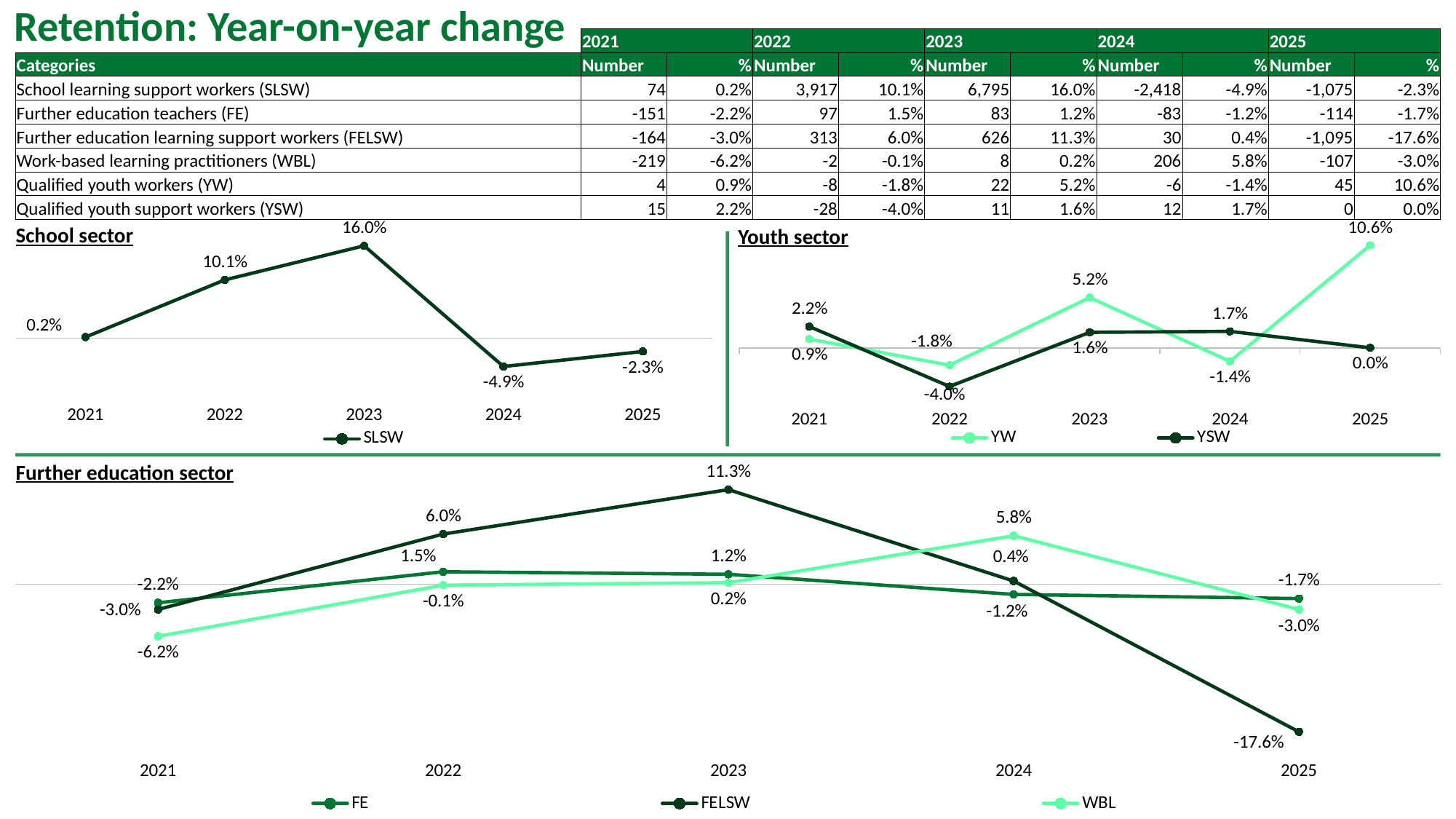
In the Youth sector chart, how many series does the legend list? 2 In the Further education sector chart, what is the value for FELSW in 2025? -17.6% In the School sector chart, which year has the lowest SLSW value? 2024 In the Youth sector chart, what is the value for YW in 2025? 10.6% In the Further education sector chart, how many years are shown on the x axis? 5 What kind of chart is the Further education sector chart? Line chart In the Youth sector chart, which is larger in 2023, YW or YSW? YW In the School sector chart, what is the difference between the SLSW values for 2023 and 2022? 5.9% In the Youth sector chart, what is the value for YSW in 2022? -4.0% In the Further education sector chart, what is the difference between the FELSW and FE values in 2023? 10.1% In the School sector chart, what is the value for SLSW in 2023? 16.0% In the Further education sector chart, which series has the highest value in 2024? WBL